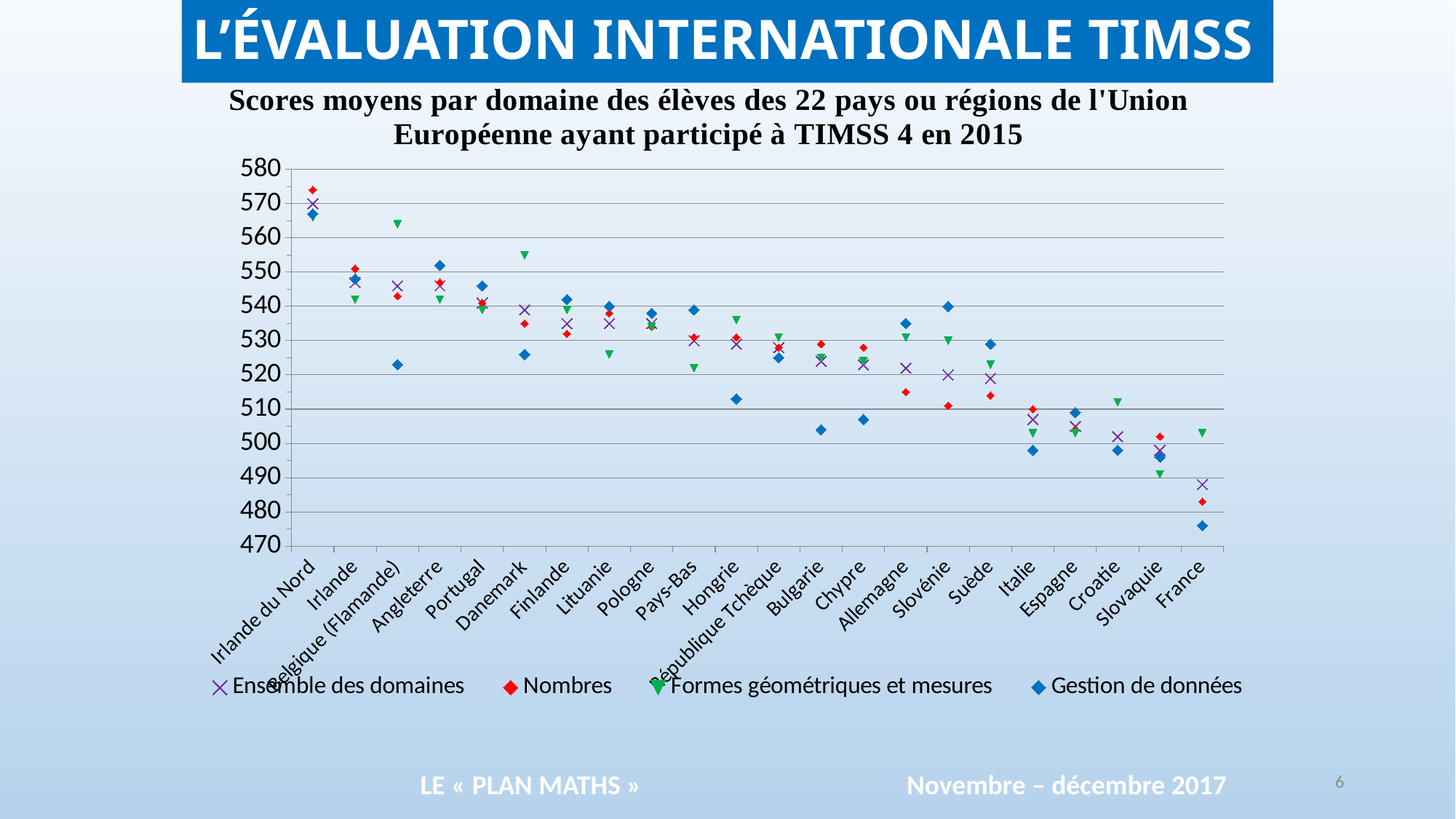
Which country has the lowest value for Gestion de données? France How many series does the legend list? 4 Do the values for Ensemble des domaines generally rise or fall from left to right along the x axis? fall How many countries or regions are plotted along the x axis? 22 Is the value for Nombres for Irlande du Nord greater or less than 570? greater Which country has the lowest value for Ensemble des domaines? France What kind of chart is shown on the slide? scatter chart Is the value for Gestion de données for France greater or less than 480? less For France, which is larger: the value for Nombres or the value for Formes géométriques et mesures? Formes géométriques et mesures Is the value for Gestion de données for Belgique (Flamande) greater or less than 530? less Which country has the highest value for Ensemble des domaines? Irlande du Nord